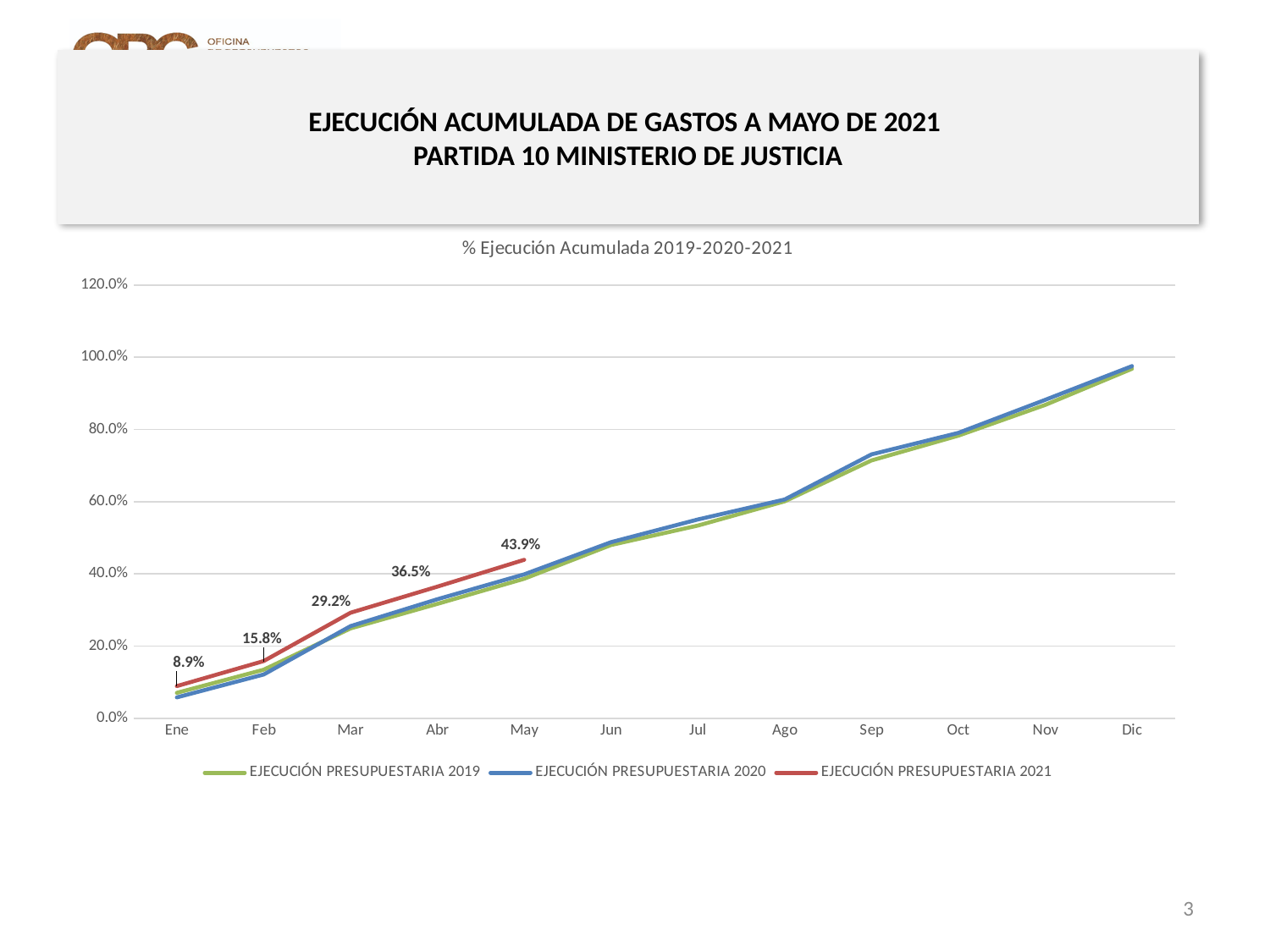
What kind of chart is shown on the slide? Line chart What is the value for EJECUCIÓN PRESUPUESTARIA 2021 in May? 43.9% What is the difference between the EJECUCIÓN PRESUPUESTARIA 2021 values for May and Ene? 35.0% What is the value for EJECUCIÓN PRESUPUESTARIA 2021 in Feb? 15.8% How many months are shown on the x axis? 12 How many series does the legend list? 3 What is the value for EJECUCIÓN PRESUPUESTARIA 2021 in Ene? 8.9% Is the value for EJECUCIÓN PRESUPUESTARIA 2019 in Sep greater or less than 60.0%? greater What is the value for EJECUCIÓN PRESUPUESTARIA 2021 in Mar? 29.2% Is the value for EJECUCIÓN PRESUPUESTARIA 2020 in Dic greater or less than 80.0%? greater What is the difference between the EJECUCIÓN PRESUPUESTARIA 2021 values for Mar and Feb? 13.4% Do the values for EJECUCIÓN PRESUPUESTARIA 2019 rise or fall from Ene to Dic? Rise